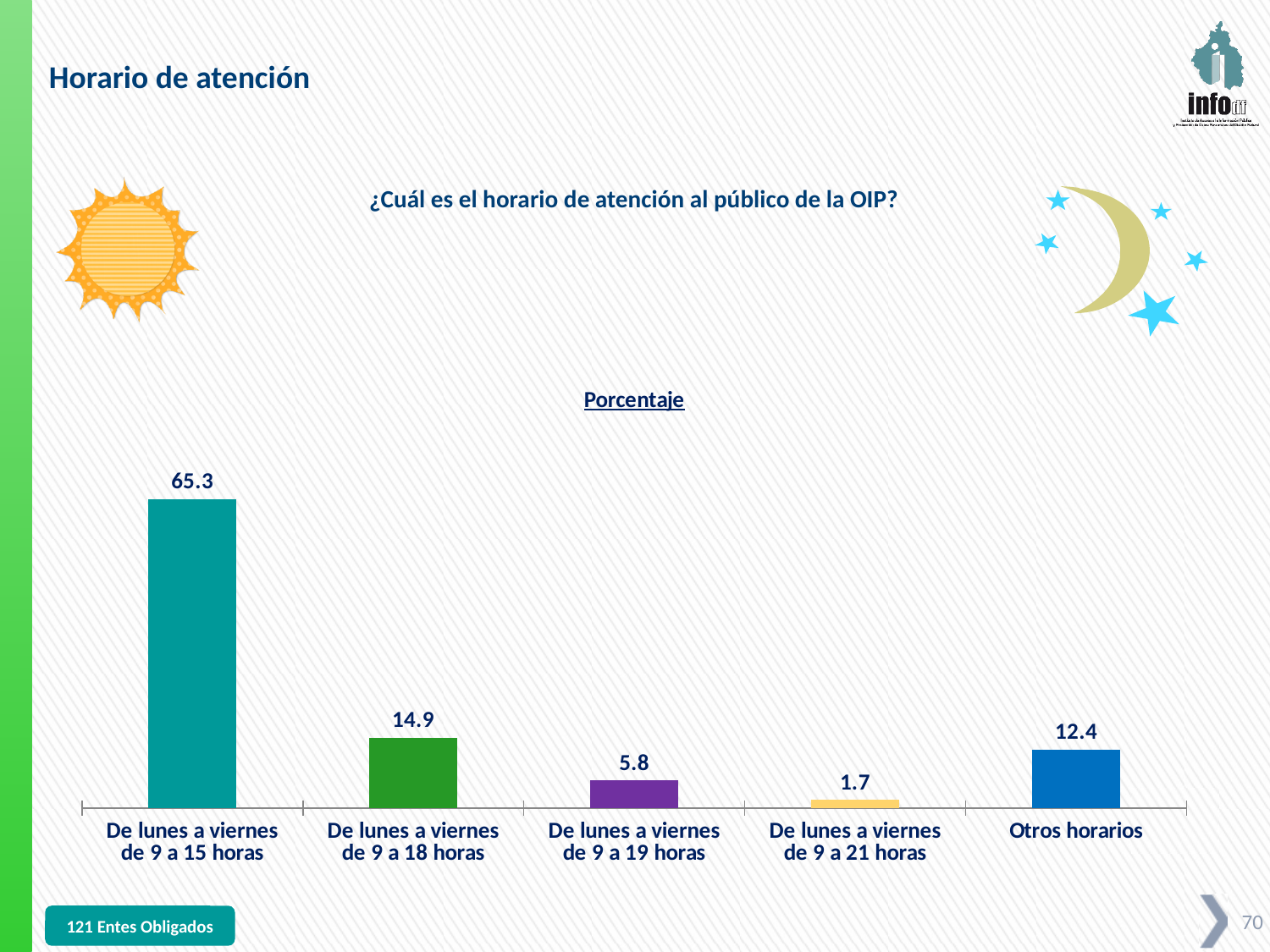
Which is larger: the value for 'De lunes a viernes de 9 a 18 horas' or 'Otros horarios'? De lunes a viernes de 9 a 18 horas Which category has the highest value? De lunes a viernes de 9 a 15 horas What is the difference between the values for 'De lunes a viernes de 9 a 15 horas' and 'De lunes a viernes de 9 a 18 horas'? 50.4 What is the difference between the values for 'Otros horarios' and 'De lunes a viernes de 9 a 19 horas'? 6.6 Which category has the lowest value? De lunes a viernes de 9 a 21 horas What is the title shown above the chart? Porcentaje What is the value for 'Otros horarios'? 12.4 What is the value for 'De lunes a viernes de 9 a 18 horas'? 14.9 How many categories are shown in the chart? 5 What is the value for 'De lunes a viernes de 9 a 21 horas'? 1.7 What kind of chart is shown on the slide? Bar chart What is the value for 'De lunes a viernes de 9 a 15 horas'? 65.3